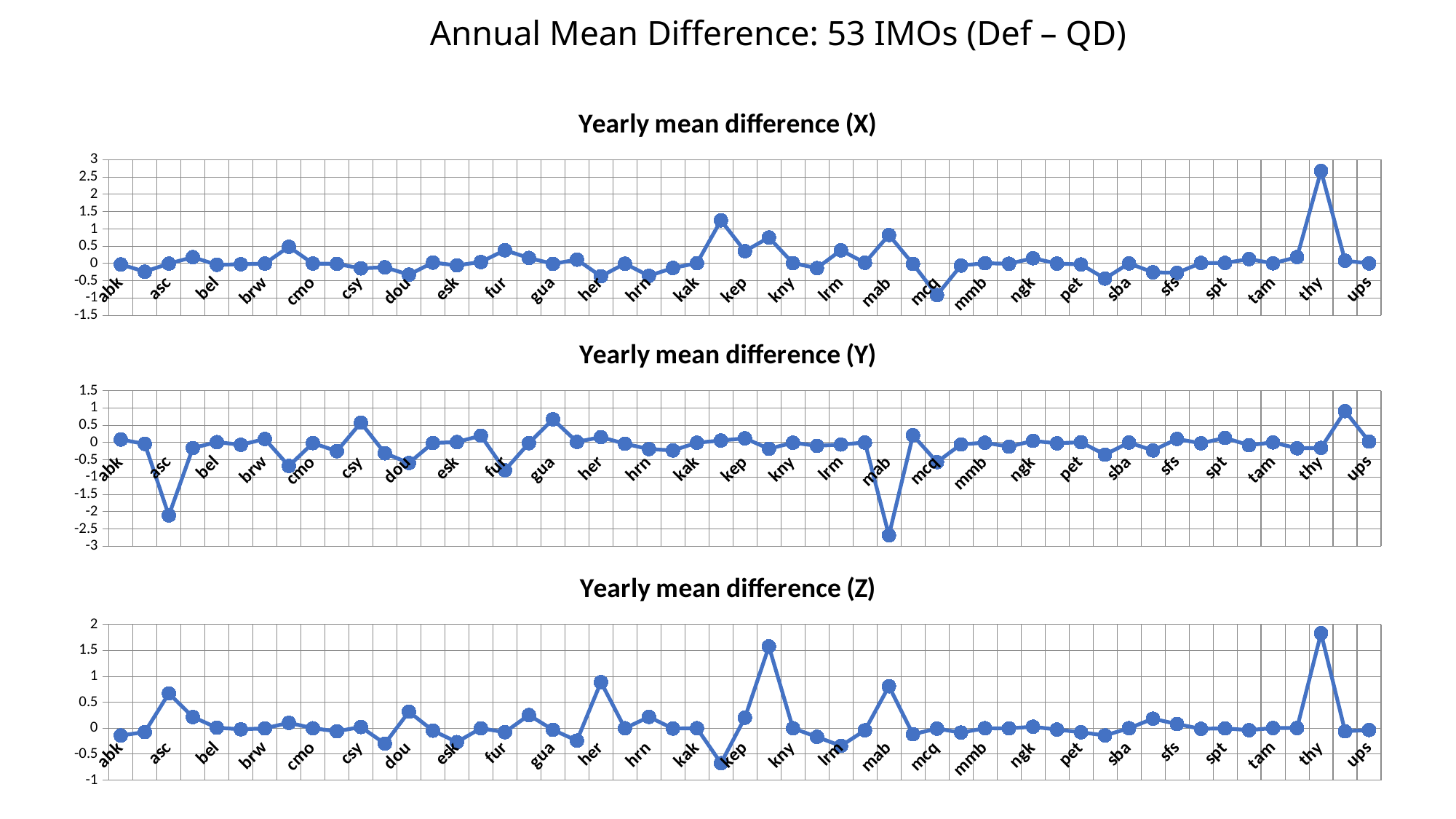
In the "Yearly mean difference (Z)" chart, is the value for her greater or less than 0.5? greater What kind of chart is "Yearly mean difference (X)"? line chart In the "Yearly mean difference (Y)" chart, is the value for asc greater or less than -1.5? less In the "Yearly mean difference (Z)" chart, is the value for thy greater or less than 1? greater What is the overall title of the slide? Annual Mean Difference: 53 IMOs (Def – QD) In the "Yearly mean difference (Z)" chart, which station has the highest value? thy In the "Yearly mean difference (Y)" chart, which station has the lowest value? mab How many charts are shown on the slide? 3 In the "Yearly mean difference (X)" chart, which station has the highest value? thy In the "Yearly mean difference (X)" chart, which station has the lowest value? mcq